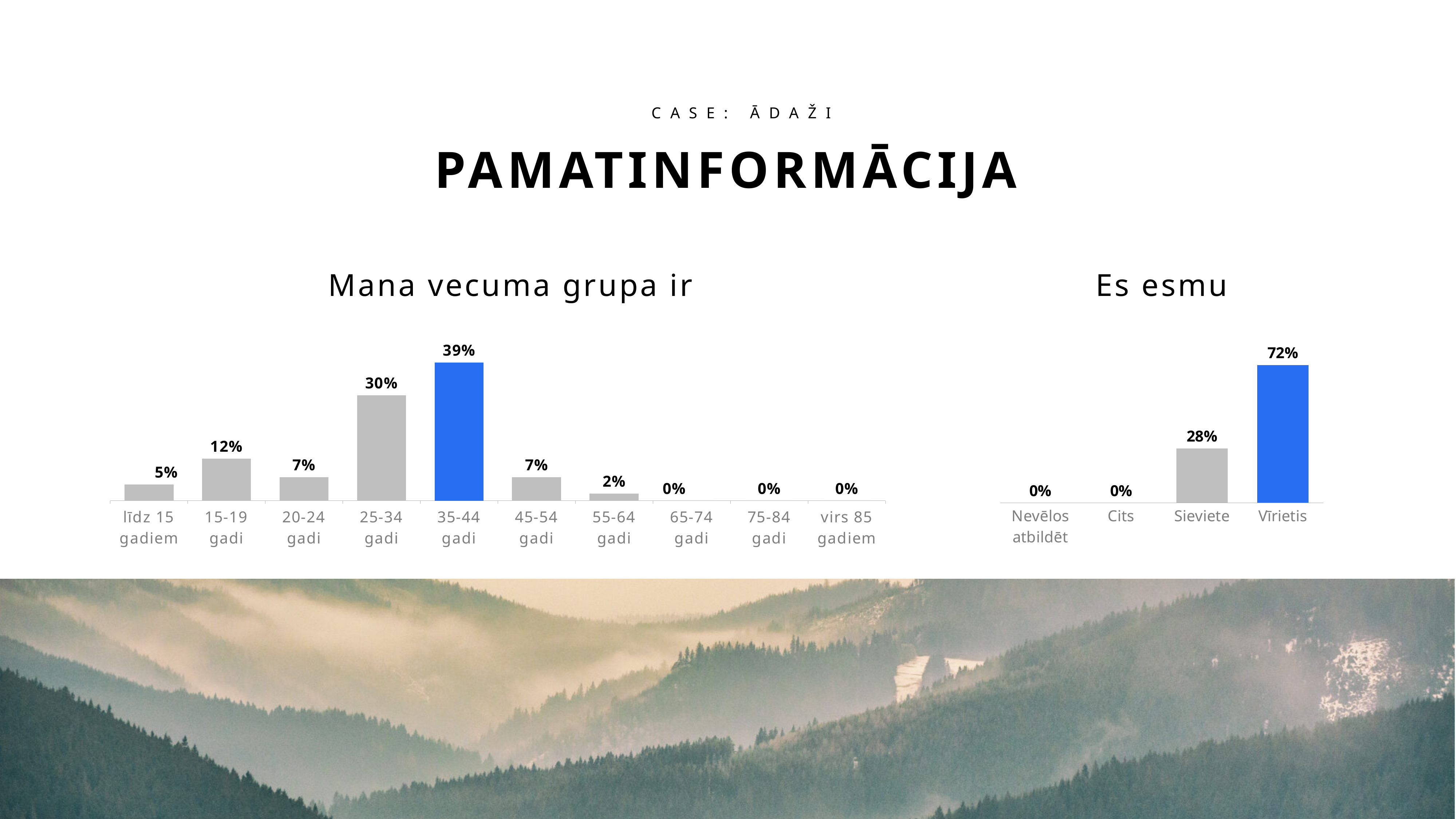
In the 'Es esmu' chart, what is the value for Vīrietis? 72% What kind of chart is the 'Es esmu' chart? Bar chart In the 'Mana vecuma grupa ir' chart, what is the value for 55-64 gadi? 2% In the 'Mana vecuma grupa ir' chart, which is larger, the value for 15-19 gadi or the value for 20-24 gadi? 15-19 gadi In the 'Es esmu' chart, which category's bar is coloured blue? Vīrietis How many age groups are shown in the 'Mana vecuma grupa ir' chart? 10 In the 'Mana vecuma grupa ir' chart, which age group has the highest value? 35-44 gadi In the 'Es esmu' chart, what is the difference between the values for Vīrietis and Sieviete? 44% In the 'Mana vecuma grupa ir' chart, what is the value for 25-34 gadi? 30% In the 'Mana vecuma grupa ir' chart, what is the value for 35-44 gadi? 39% In the 'Es esmu' chart, what is the value for Sieviete? 28% In the 'Mana vecuma grupa ir' chart, what is the difference between the values for 35-44 gadi and 25-34 gadi? 9%